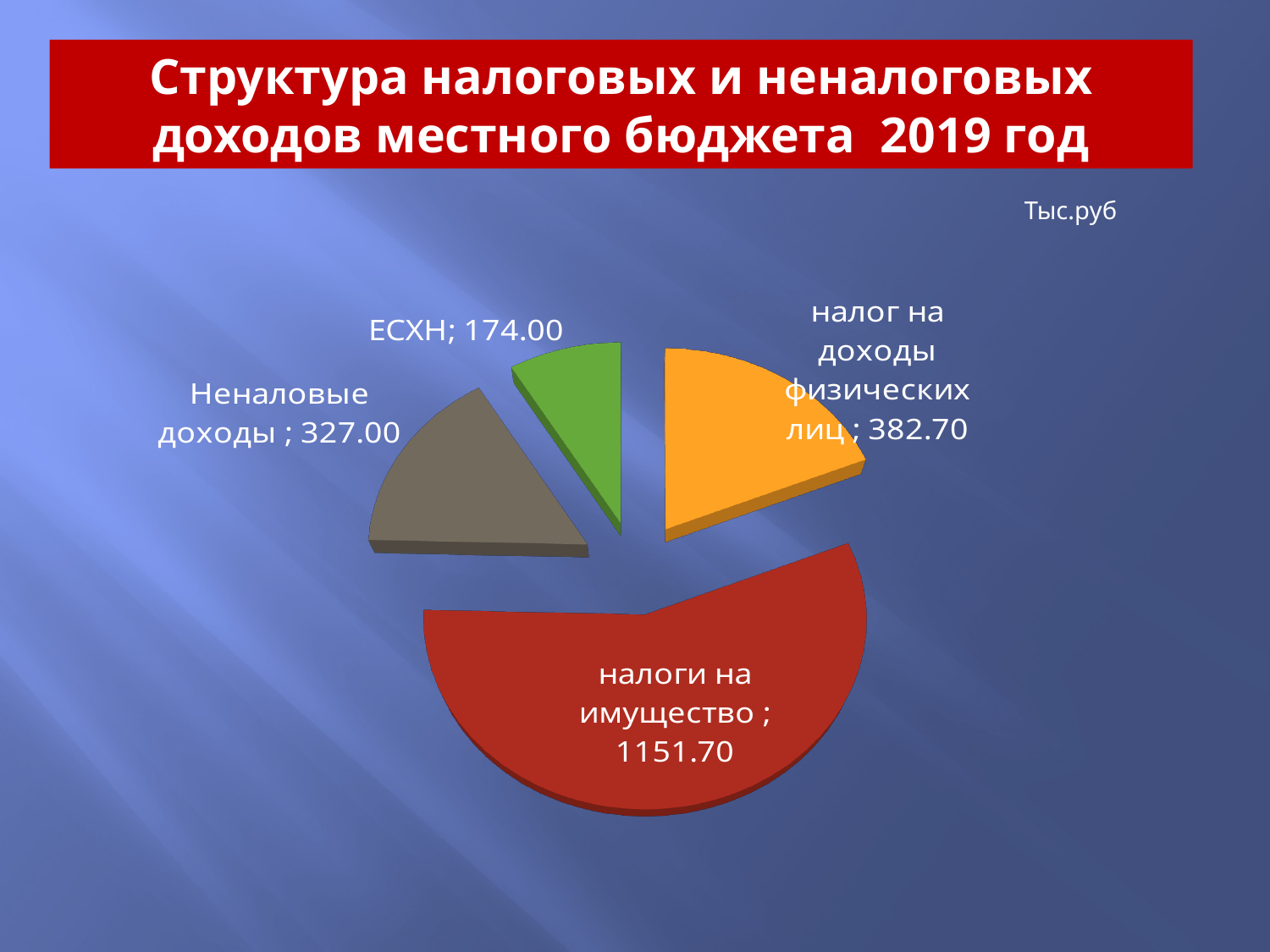
What is the value for налог на доходы физических лиц? 382.70 What type of chart is shown on the slide? Pie chart Which category has the largest slice of the pie? налоги на имущество What unit of measurement is indicated for the chart values? Тыс.руб What is the value for Неналовые доходы? 327.00 What is the value for ЕСХН? 174.00 What is the difference between налоги на имущество and налог на доходы физических лиц? 769.00 What is the total of all slices in the pie chart? 2035.40 Which is larger: налог на доходы физических лиц or Неналовые доходы? налог на доходы физических лиц How many slices does the pie chart have? 4 Which category has the smallest slice of the pie? ЕСХН What is the value for налоги на имущество? 1151.70